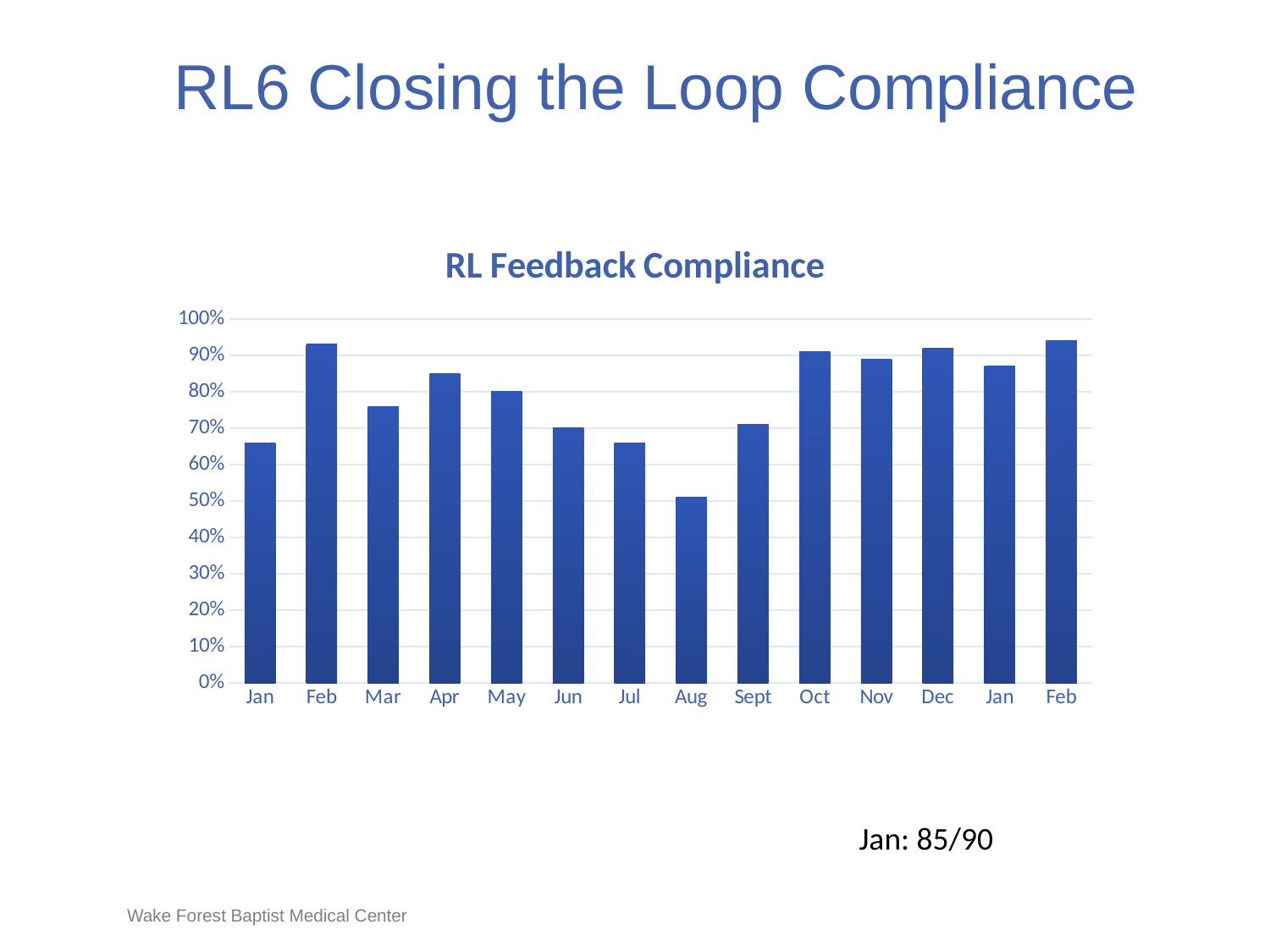
Which is larger, the value for Sept or the value for Oct? Oct Is the value for Mar greater or less than 80%? less Is the value for Oct greater or less than 80%? greater How many bars (months) are plotted in the chart? 14 Which is larger, the value for Apr or the value for Mar? Apr Is the value for Apr greater or less than 80%? greater Do the values rise or fall from Jun to Aug? fall Which month has the lowest compliance value? Aug What kind of chart is shown on the slide? bar chart What is the title of the chart? RL Feedback Compliance